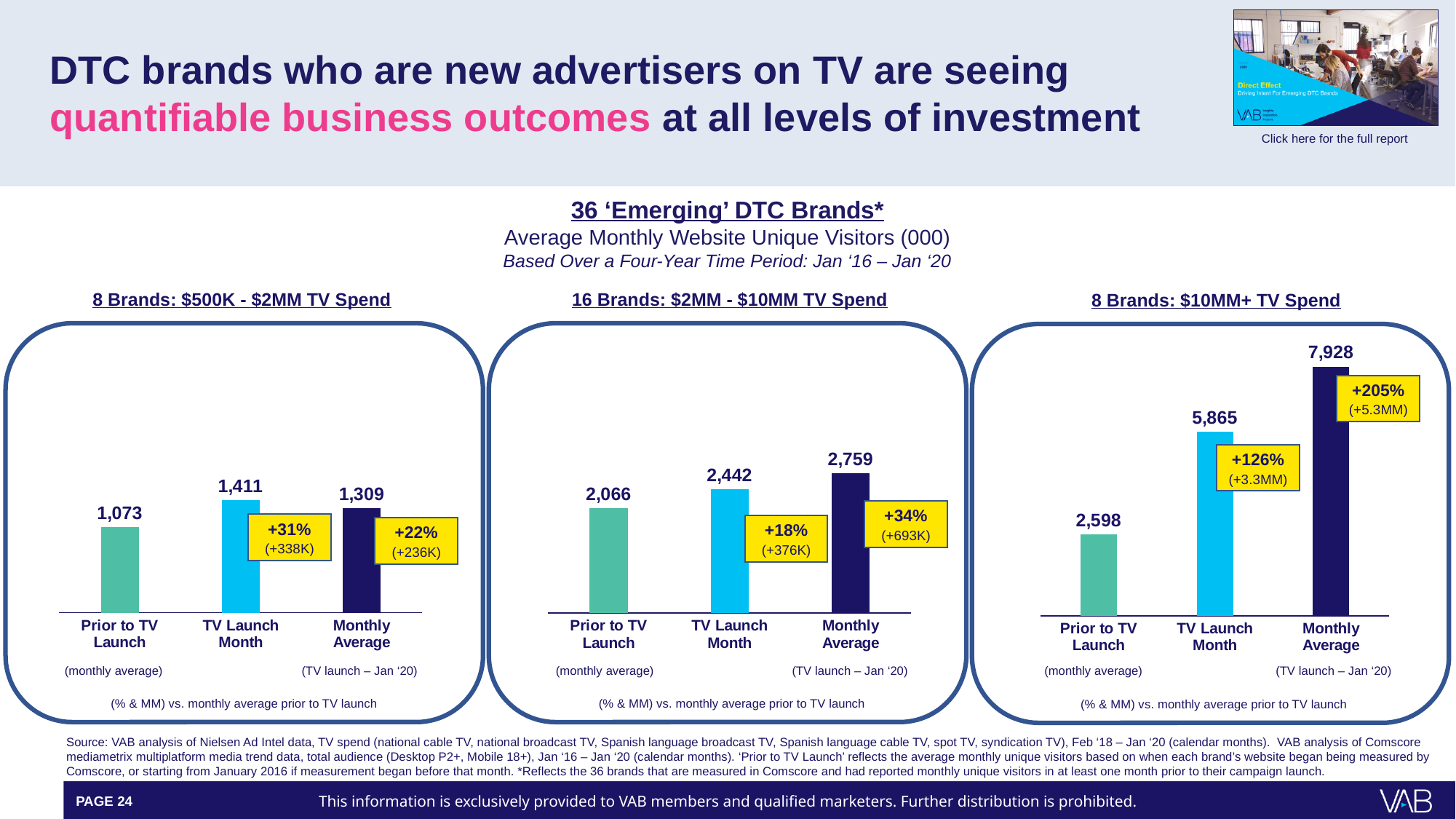
In the '8 Brands: $10MM+ TV Spend' chart, what is the difference between Monthly Average and Prior to TV Launch? 5,330 What kind of chart is the '8 Brands: $10MM+ TV Spend' chart? Bar chart How many bars are in the '16 Brands: $2MM - $10MM TV Spend' chart? 3 In the '16 Brands: $2MM - $10MM TV Spend' chart, what is the value for TV Launch Month? 2,442 In the '8 Brands: $500K - $2MM TV Spend' chart, what is the value for Prior to TV Launch? 1,073 In the '8 Brands: $500K - $2MM TV Spend' chart, which is larger, TV Launch Month or Monthly Average? TV Launch Month In the '8 Brands: $10MM+ TV Spend' chart, which category has the lowest value? Prior to TV Launch In the '8 Brands: $10MM+ TV Spend' chart, what is the value for Monthly Average? 7,928 In the '8 Brands: $500K - $2MM TV Spend' chart, which category has the highest value? TV Launch Month In the '8 Brands: $10MM+ TV Spend' chart, what percentage change is shown in the label next to the Monthly Average bar? +205% In the '16 Brands: $2MM - $10MM TV Spend' chart, do the values rise or fall from left to right? Rise In the '16 Brands: $2MM - $10MM TV Spend' chart, what is the difference between Monthly Average and Prior to TV Launch? 693